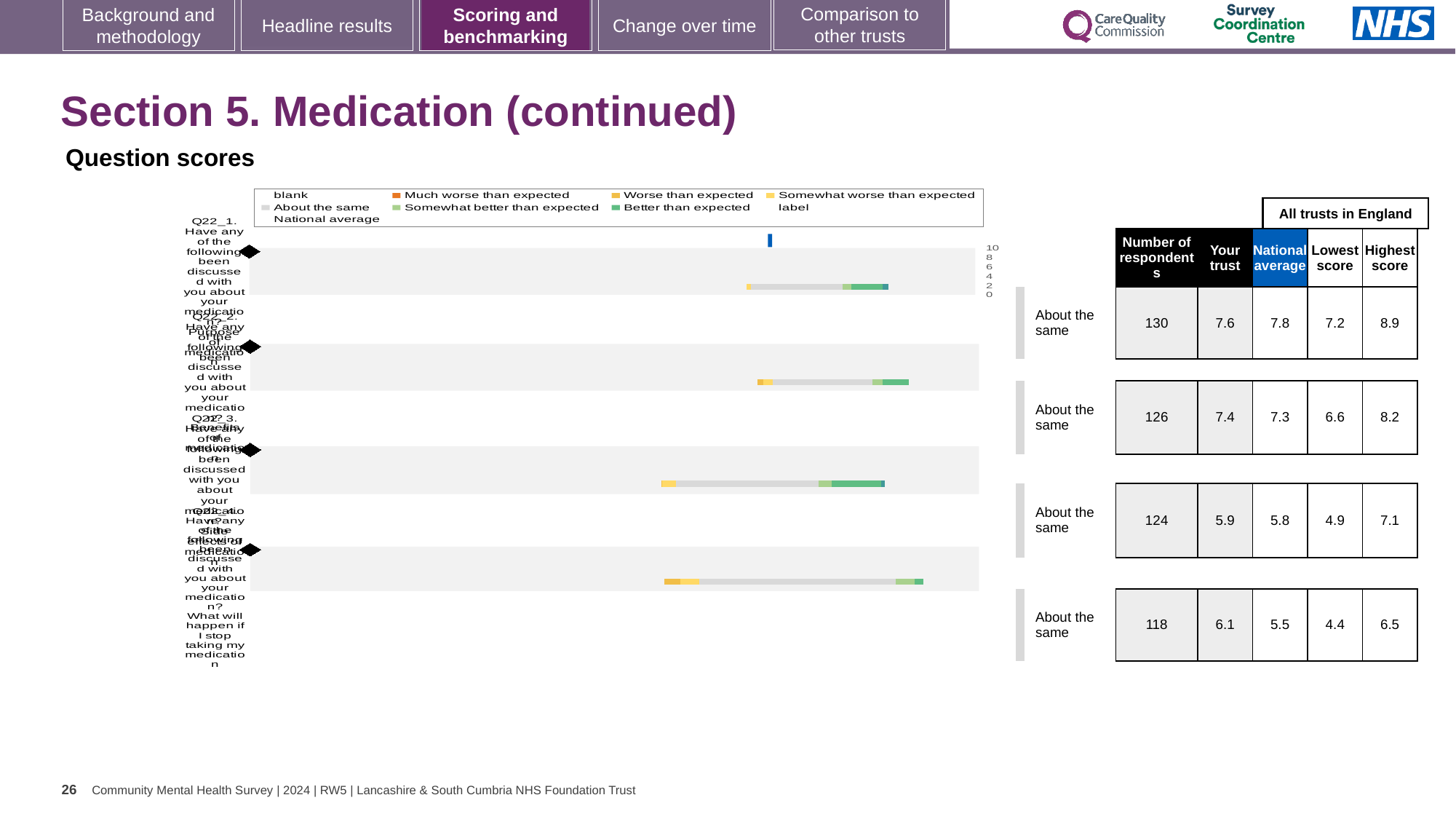
How many question bars are plotted in the chart? 4 In the table, what is the number of respondents for the first question (Q22_1)? 130 For the fourth question row, what is the difference between the 'Your trust' score and the national average? 0.6 In the table, what is the 'Your trust' score for the first question (Q22_1)? 7.6 In the table, what is the highest score in England for the second question row? 8.2 What colour does the legend use for 'Better than expected'? green Which question row has the lowest 'Your trust' score in the table? the third row, 5.9 In the table, what is the lowest score in England for the fourth question row? 4.4 What kind of chart is shown under 'Question scores'? bar chart What benchmark label is shown next to each of the four question bars? About the same For the first question row (Q22_1), which is larger: the 'Your trust' score or the national average? National average Which question row has the highest 'Your trust' score in the table? the first row (Q22_1), 7.6